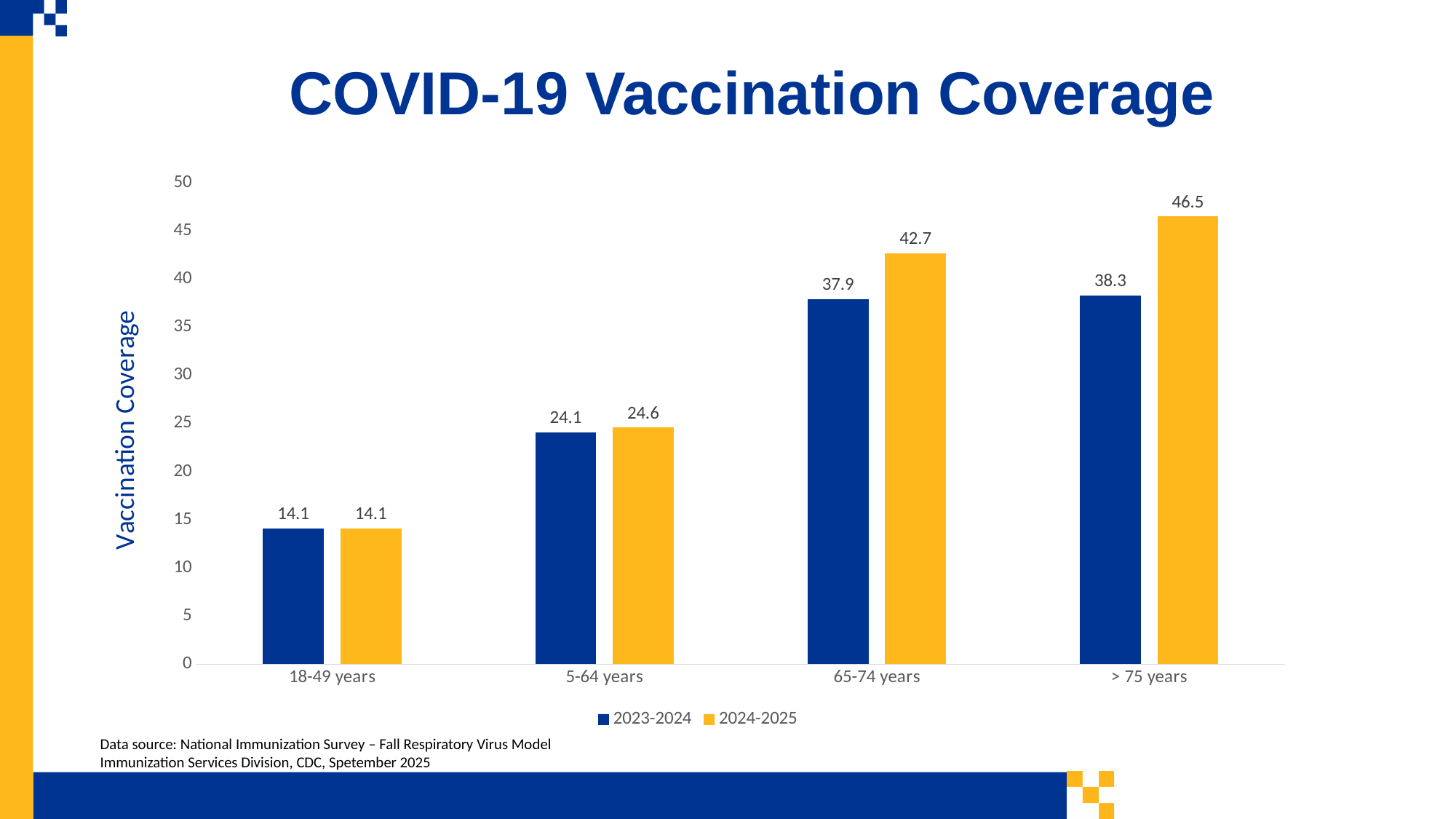
What is the difference between the 2024-2025 and 2023-2024 vaccination coverage for the > 75 years group? 8.2 How many age groups are shown on the x axis? 4 What is the difference between the 2024-2025 and 2023-2024 vaccination coverage for the 65-74 years group? 4.8 What is the 2023-2024 vaccination coverage for the 65-74 years group? 37.9 What is the 2024-2025 vaccination coverage for the > 75 years group? 46.5 What is the title of the chart? COVID-19 Vaccination Coverage How many series does the legend list? 2 Which age group has the lowest 2023-2024 vaccination coverage? 18-49 years Which age group has the highest 2024-2025 vaccination coverage? > 75 years What kind of chart is shown on the slide? Bar chart What is the 2023-2024 vaccination coverage for the 5-64 years group? 24.1 Which is larger for the 5-64 years group: the 2023-2024 or the 2024-2025 vaccination coverage? 2024-2025